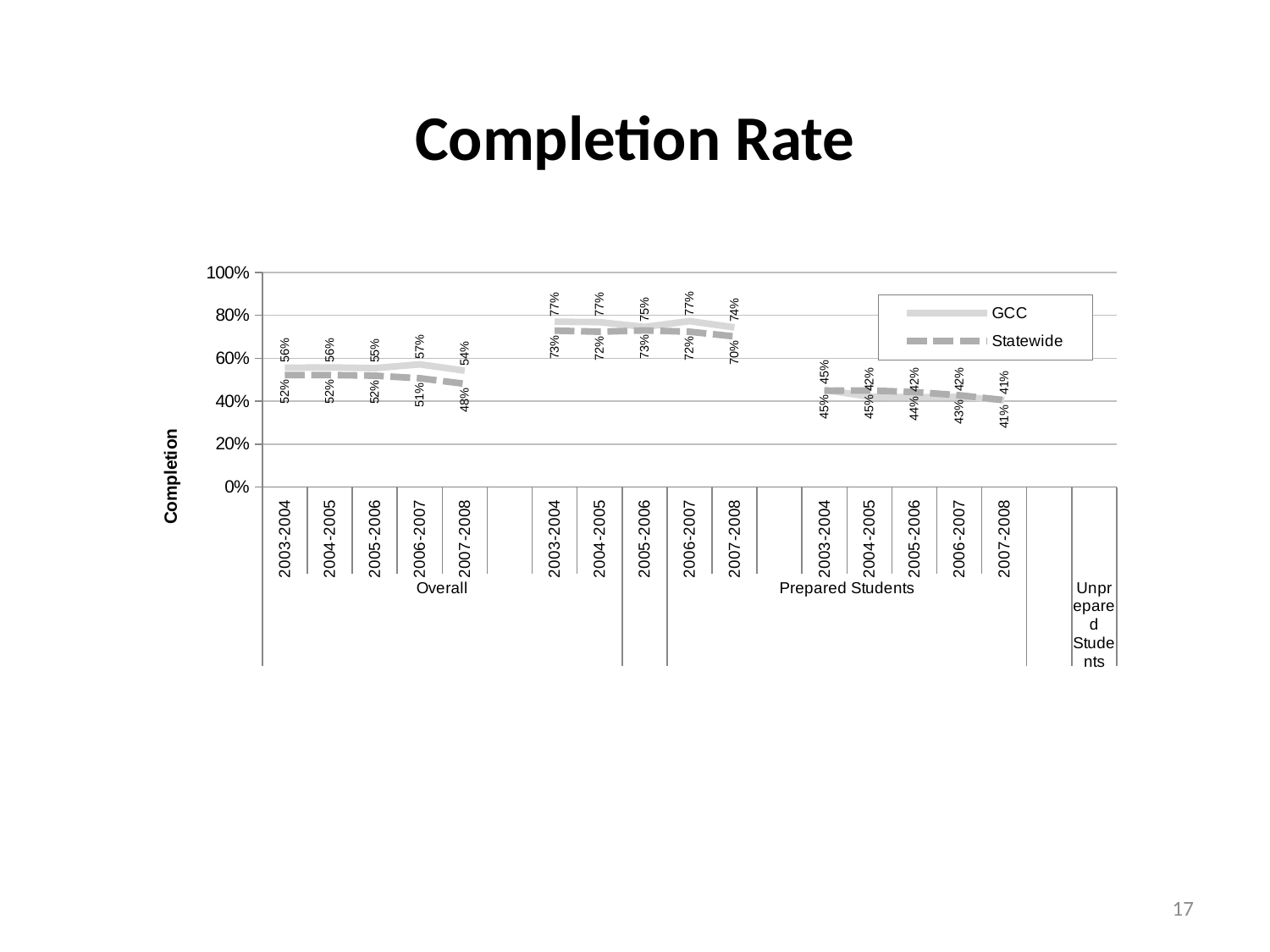
In the Overall group, what is the Statewide completion rate for 2007-2008? 48% In the Overall group, does the Statewide completion rate rise or fall from 2003-2004 to 2007-2008? Fall In the Overall group, what is the GCC completion rate for 2006-2007? 57% In the right-hand group of years (values in the 40s), what is the completion rate shown for 2007-2008? 41% What kind of chart is shown on the slide? Line chart In the Overall group, which year has the highest GCC completion rate? 2006-2007 How many series does the legend list? 2 In the Overall group, which year has the lowest Statewide completion rate? 2007-2008 In the Overall group, what is the difference between the GCC and Statewide completion rates for 2007-2008? 6 percentage points In the middle group of years (values in the 70s), which is larger for 2005-2006, GCC or Statewide? GCC In the middle group of years (values in the 70s), what is the GCC completion rate for 2007-2008? 74% What are the two series named in the legend? GCC and Statewide